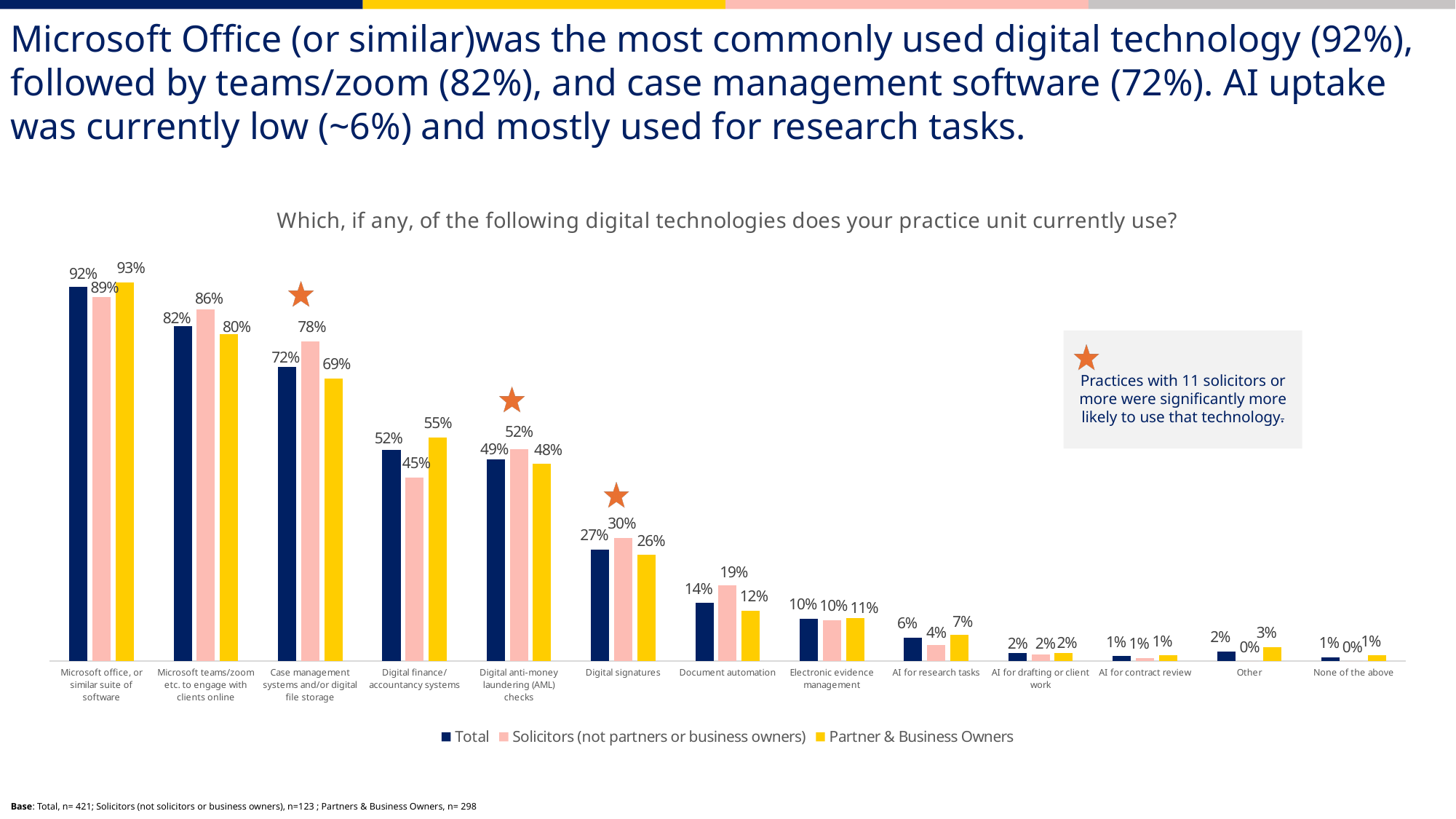
How many categories are shown on the x axis? 13 Which category has the lowest Solicitors (not partners or business owners) value? Other and None of the above (both 0%) What is the difference between the Solicitors and Partner & Business Owners values for Document automation? 7 percentage points What is the Total value for Microsoft office, or similar suite of software? 92% For Digital finance/accountancy systems, which is larger: the Total value or the Solicitors value? Total How many series does the legend list? 3 What is the Solicitors (not partners or business owners) value for Case management systems and/or digital file storage? 78% Do the Total values rise or fall moving from left to right along the x axis? Fall What kind of chart is shown on the slide? Bar chart What is the Partner & Business Owners value for Digital finance/accountancy systems? 55% What is the Total value for AI for research tasks? 6% Which category has the highest Total value? Microsoft office, or similar suite of software